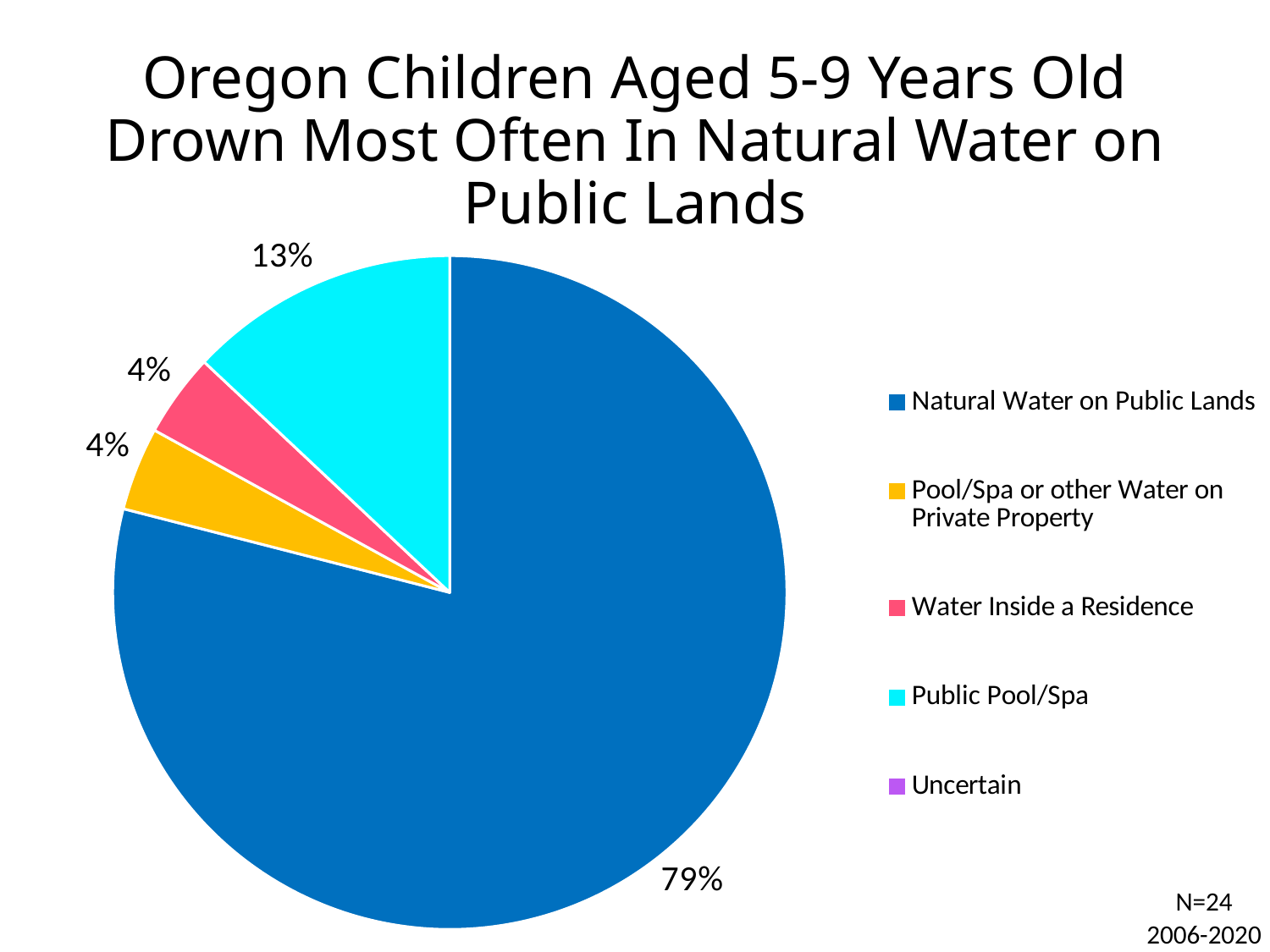
What percentage of the pie is Natural Water on Public Lands? 79% How many entries does the legend list? 5 Which is larger, the slice for Public Pool/Spa or the slice for Water Inside a Residence? Public Pool/Spa What years does the chart cover, according to the note on the slide? 2006-2020 What is the value shown for Pool/Spa or other Water on Private Property? 4% What is the value shown for Water Inside a Residence? 4% What share of the pie does Public Pool/Spa represent? 13% What is the sample size (N) noted on the slide? N=24 What is the difference between the Natural Water on Public Lands share and the Public Pool/Spa share? 66 percentage points Which category has the largest slice of the pie? Natural Water on Public Lands What type of chart is shown on the slide? Pie chart